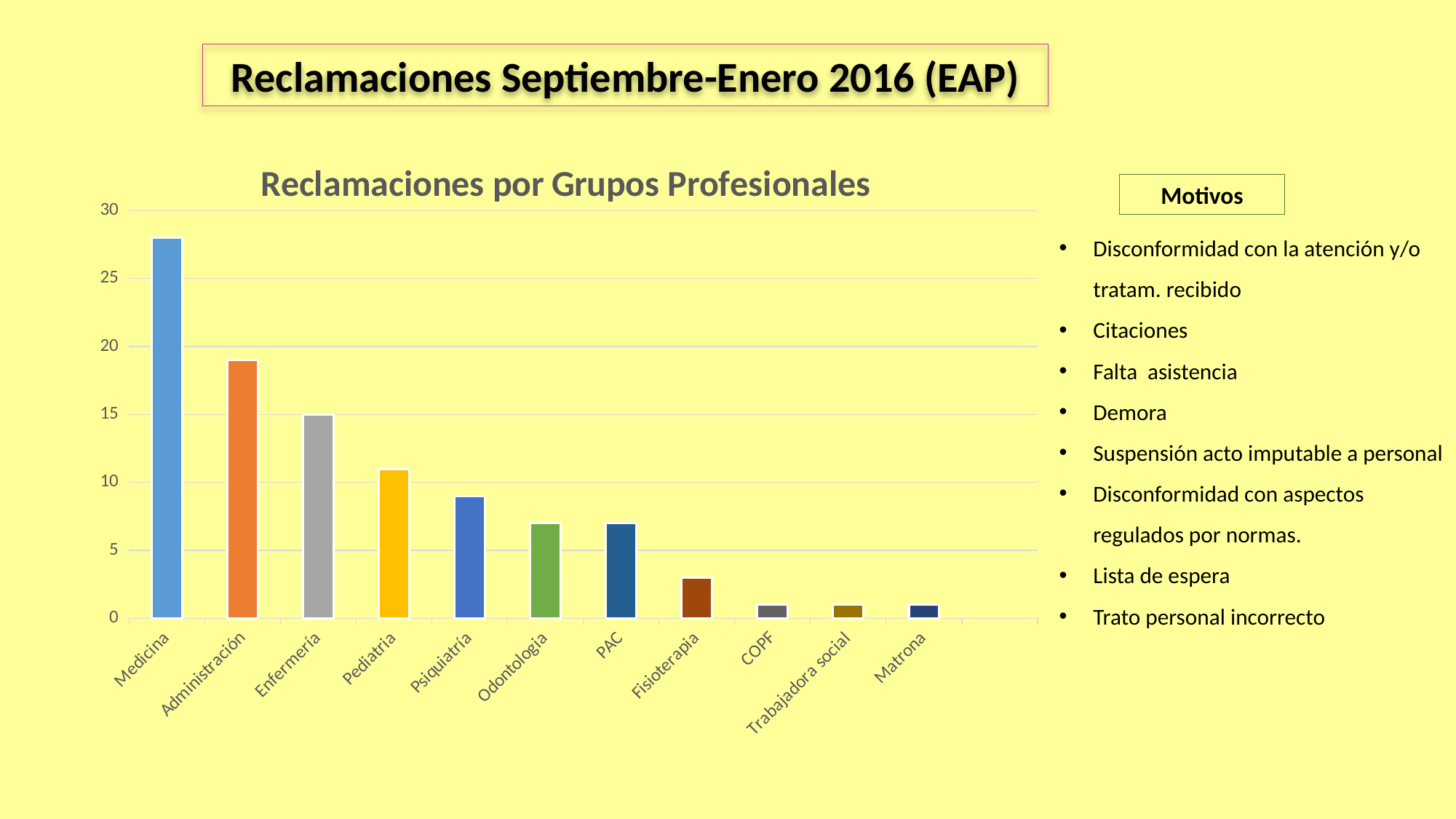
How many professional groups are shown on the x axis of the chart? 11 Is the value for Pediatria greater or less than 10? greater Which has more reclamaciones, Medicina or Administración? Medicina What is the value for Enfermería? 15 Is the value for Administración greater or less than 20? less What type of chart is shown on the slide? Bar chart Is the value for Medicina greater or less than 25? greater Do the values generally rise or fall from left to right along the x axis? Fall Which professional group has the highest number of reclamaciones? Medicina What is the title of the chart? Reclamaciones por Grupos Profesionales Which has more reclamaciones, Pediatria or Fisioterapia? Pediatria